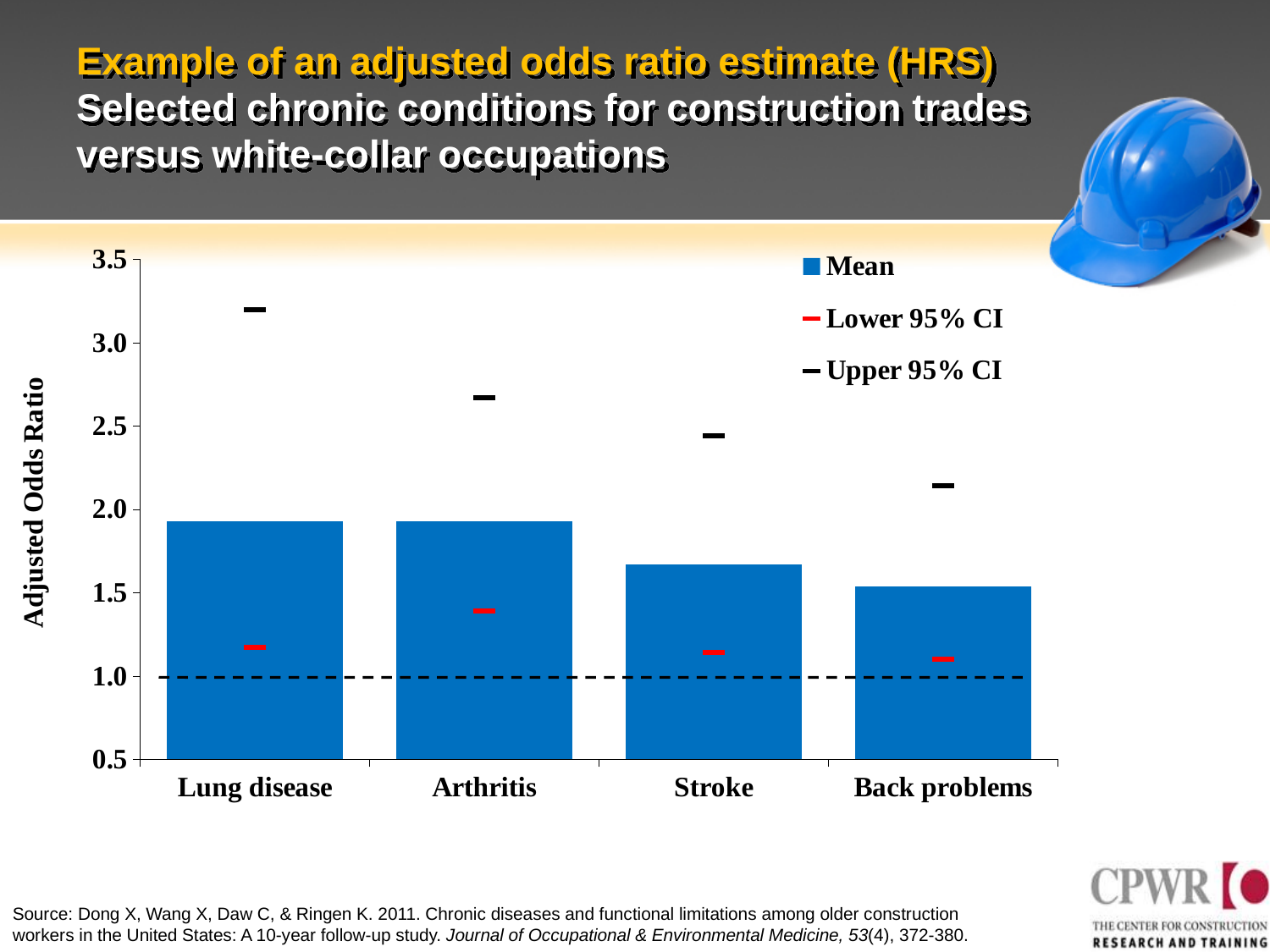
How many series does the chart's legend list? 3 Is the Mean value for Lung disease greater or less than 2.0? less Is the Upper 95% CI value for Lung disease greater or less than 3.0? greater Which has the larger Mean value, Stroke or Back problems? Stroke Which condition has the highest Upper 95% CI value? Lung disease How many chronic conditions are shown on the x axis of the chart? 4 What is the label on the chart's vertical axis? Adjusted Odds Ratio Is the Mean value for Stroke greater or less than 1.5? greater Which condition has the highest Lower 95% CI value? Arthritis What kind of chart is shown on the slide? Bar chart Which condition has the lowest Mean adjusted odds ratio? Back problems Which condition has the lowest Upper 95% CI value? Back problems